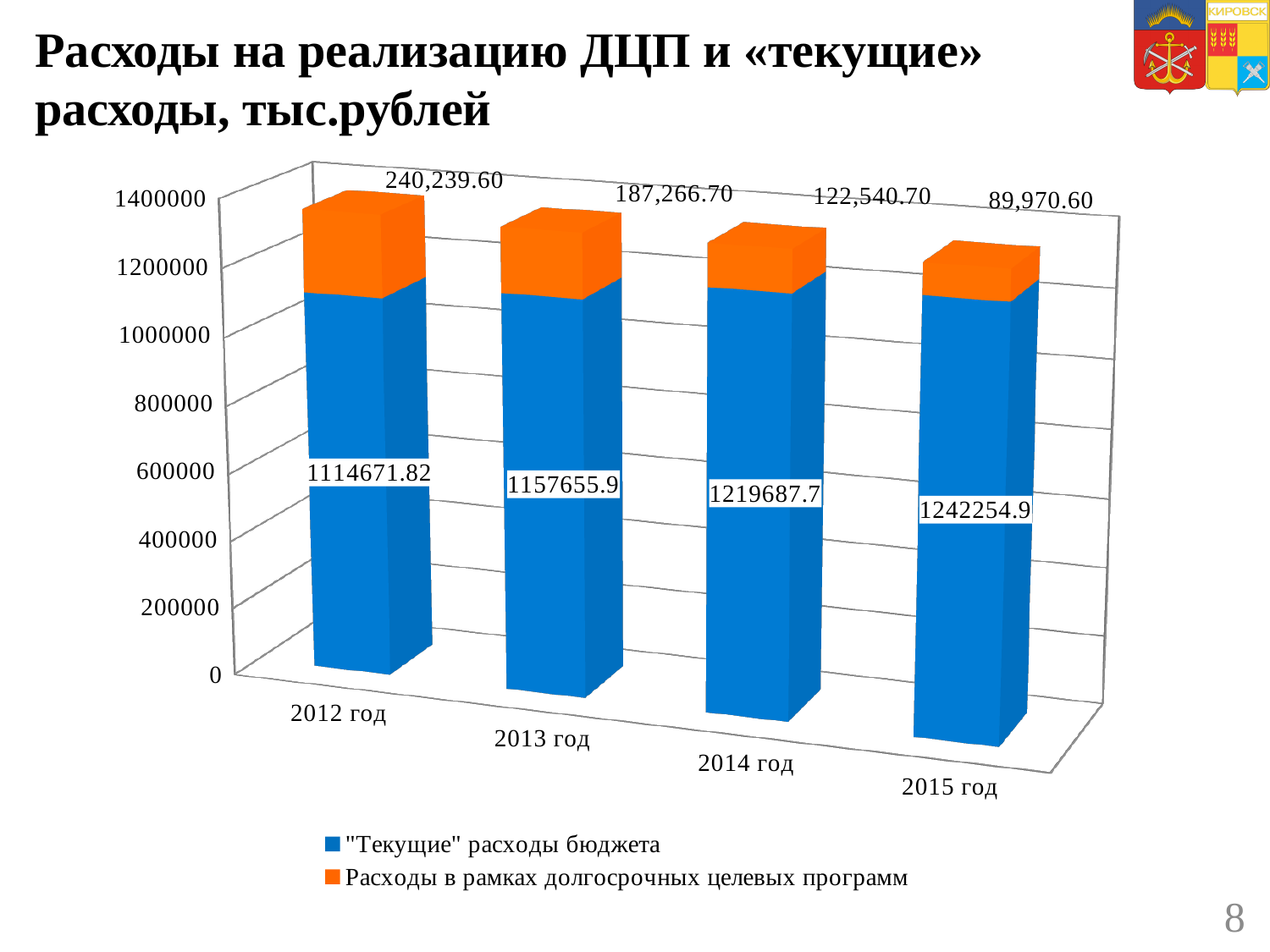
What kind of chart is shown on the slide? Stacked bar chart How many years are shown on the x axis? 4 What is the total of the stacked bar for 2014 год? 1342228.4 What is the value of Расходы в рамках долгосрочных целевых программ for 2013 год? 187,266.70 Do the values for Расходы в рамках долгосрочных целевых программ rise or fall from 2012 год to 2015 год? Fall What is the difference between the Расходы в рамках долгосрочных целевых программ values for 2012 год and 2015 год? 150,269.00 What is the value of "Текущие" расходы бюджета for 2012 год? 1114671.82 What is the value of Расходы в рамках долгосрочных целевых программ for 2015 год? 89,970.60 Which year has the highest value for "Текущие" расходы бюджета? 2015 год Which year has the lowest value for Расходы в рамках долгосрочных целевых программ? 2015 год Which is larger: "Текущие" расходы бюджета for 2013 год or for 2014 год? 2014 год How many series does the legend list? 2